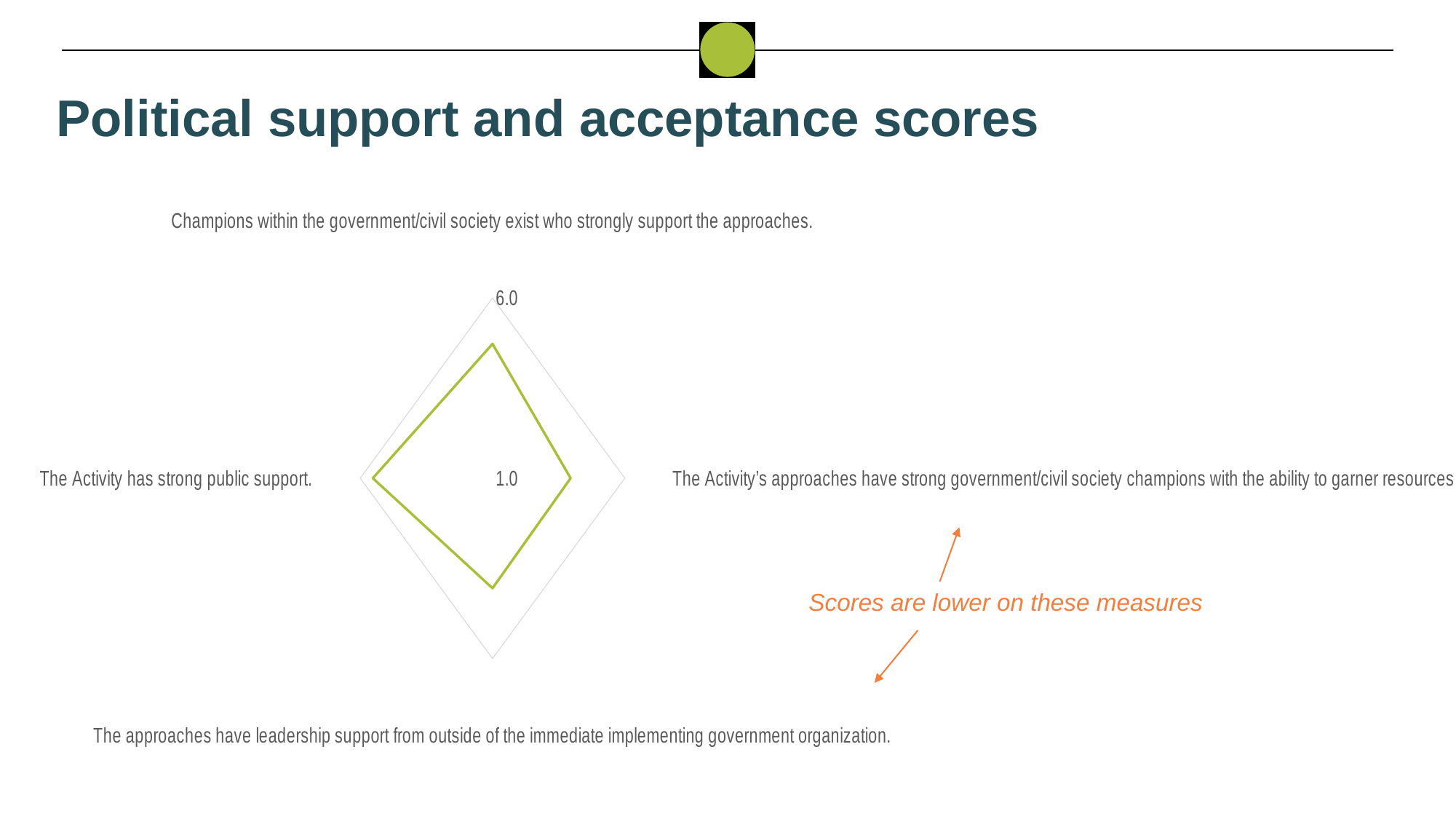
Is the score for "The Activity's approaches have strong government/civil society champions with the ability to garner resources" greater or less than 6.0? less Which is larger: the score for "The Activity has strong public support." or the score for "The Activity's approaches have strong government/civil society champions with the ability to garner resources"? The Activity has strong public support. What kind of chart is shown on the slide? Radar chart What is the title of the slide containing the radar chart? Political support and acceptance scores Is the score for "Champions within the government/civil society exist who strongly support the approaches." greater or less than 1.0? greater What is the highest value shown on the radar chart's axis scale? 6.0 Is the score for "The approaches have leadership support from outside of the immediate implementing government organization." greater or less than 6.0? less Which is larger: the score for "Champions within the government/civil society exist who strongly support the approaches." or the score for "The Activity's approaches have strong government/civil society champions with the ability to garner resources"? Champions within the government/civil society exist who strongly support the approaches. How many measures (axes) does the radar chart plot? 4 Which measure has the highest score on the radar chart? The Activity has strong public support.